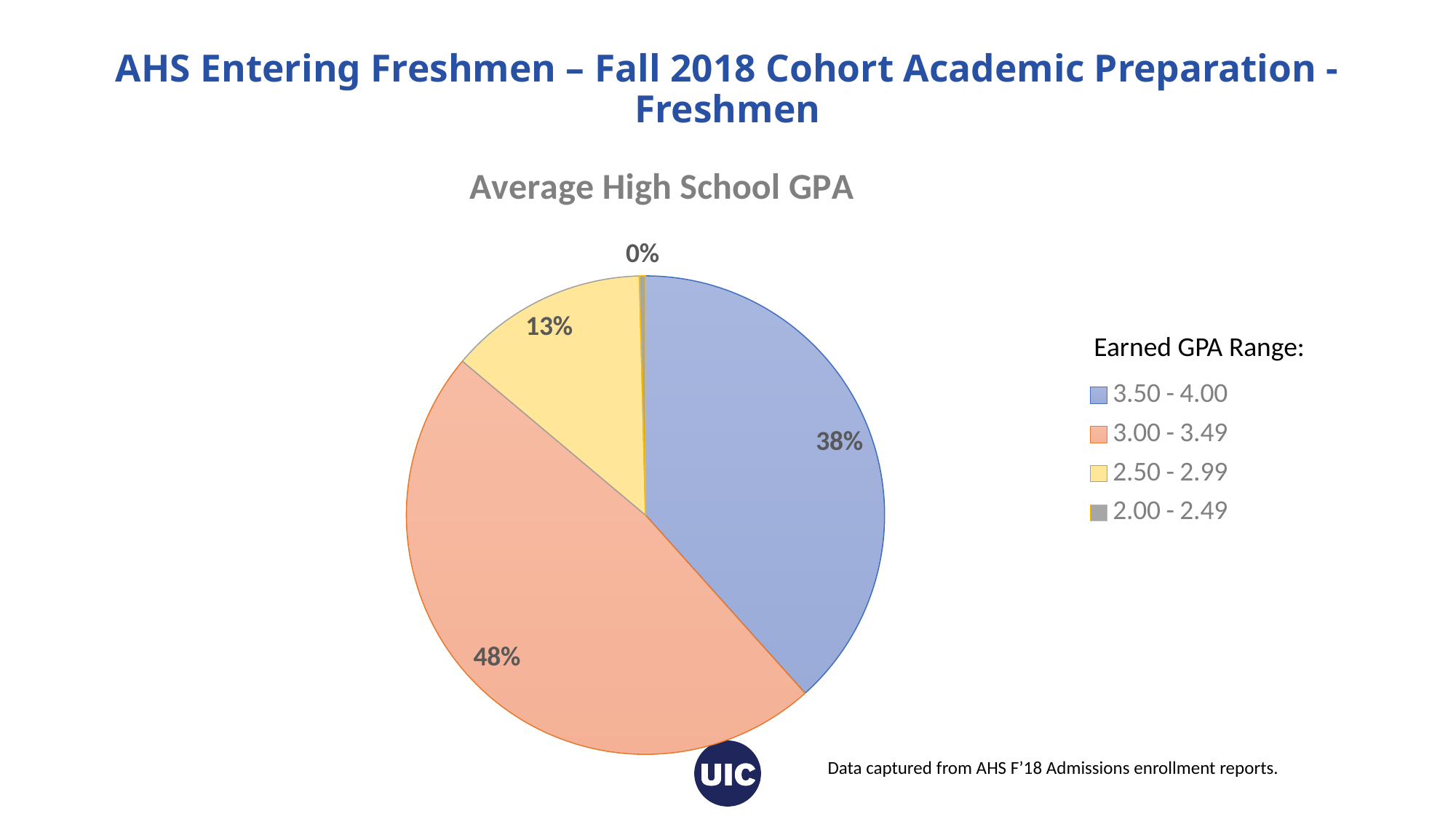
Which GPA range has the largest share of the pie? 3.00 - 3.49 What share of the pie does the 3.50 - 4.00 GPA range represent? 38% What kind of chart is shown on the slide? Pie chart What share of the pie does the 3.00 - 3.49 GPA range represent? 48% What percentage is shown for the 2.00 - 2.49 GPA range? 0% Which slice is larger: 3.50 - 4.00 or 2.50 - 2.99? 3.50 - 4.00 What colour is the slice for the 2.50 - 2.99 GPA range? Yellow Which GPA range has the smallest share of the pie? 2.00 - 2.49 What is the title of the chart? Average High School GPA What share of the pie does the 2.50 - 2.99 GPA range represent? 13% What is the difference in percentage points between the 3.00 - 3.49 and 3.50 - 4.00 slices? 10 How many GPA ranges does the legend list? 4